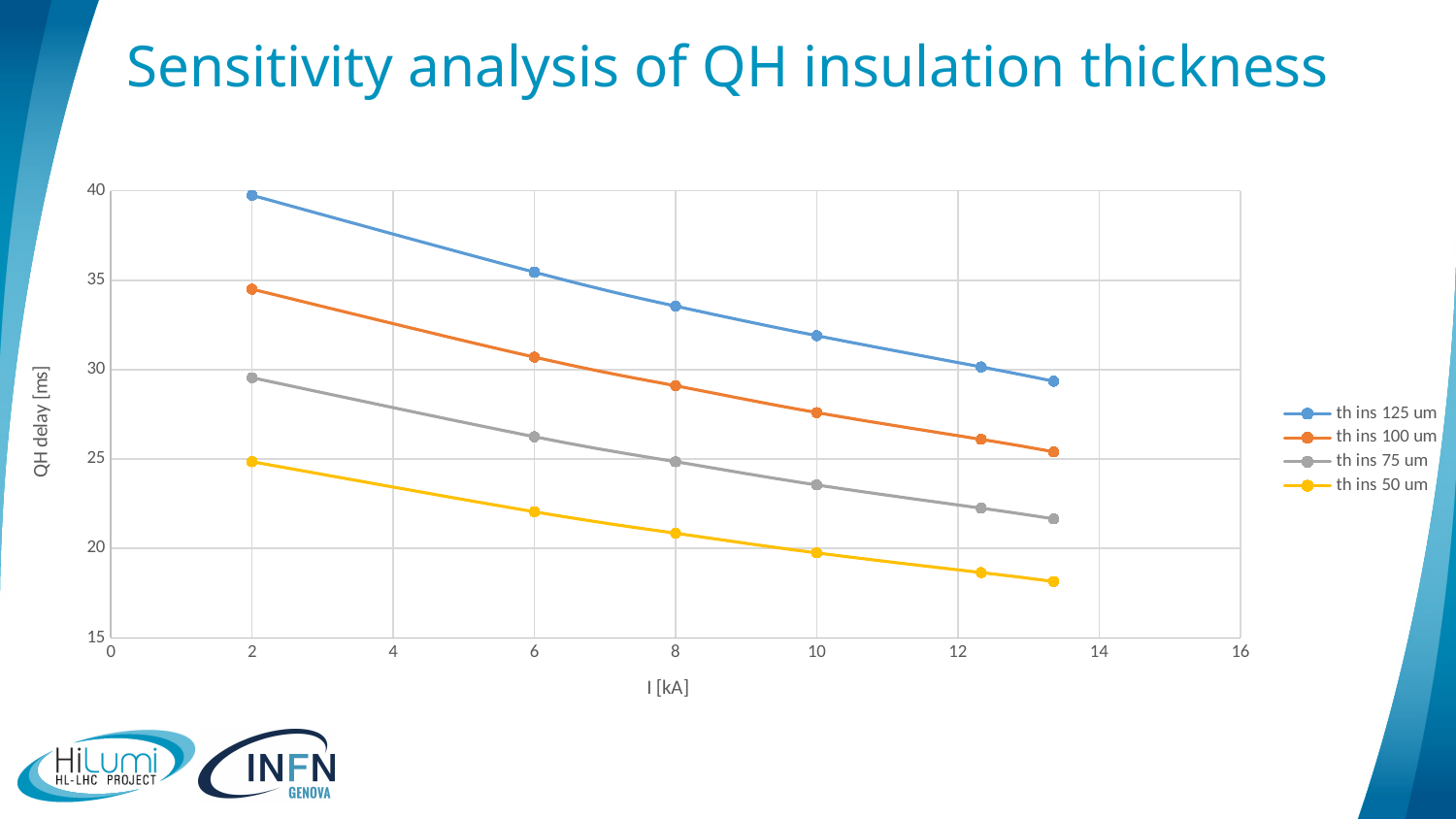
At I = 8 kA, which series has the larger QH delay, th ins 125 um or th ins 100 um? th ins 125 um What kind of chart is shown on the slide? line chart How many data points are plotted for the th ins 125 um series? 6 Which series has the lowest QH delay values across the current range? th ins 50 um Is the QH delay for th ins 75 um at I = 6 kA greater or less than 25 ms? greater Do the QH delay values rise or fall as the current I increases? fall Is the QH delay for th ins 125 um at I = 2 kA greater or less than 35 ms? greater Which series has the highest QH delay values across the current range? th ins 125 um Is the QH delay for th ins 50 um at I = 8 kA greater or less than 20 ms? greater How many series does the legend list? 4 What is the label of the y axis? QH delay [ms]